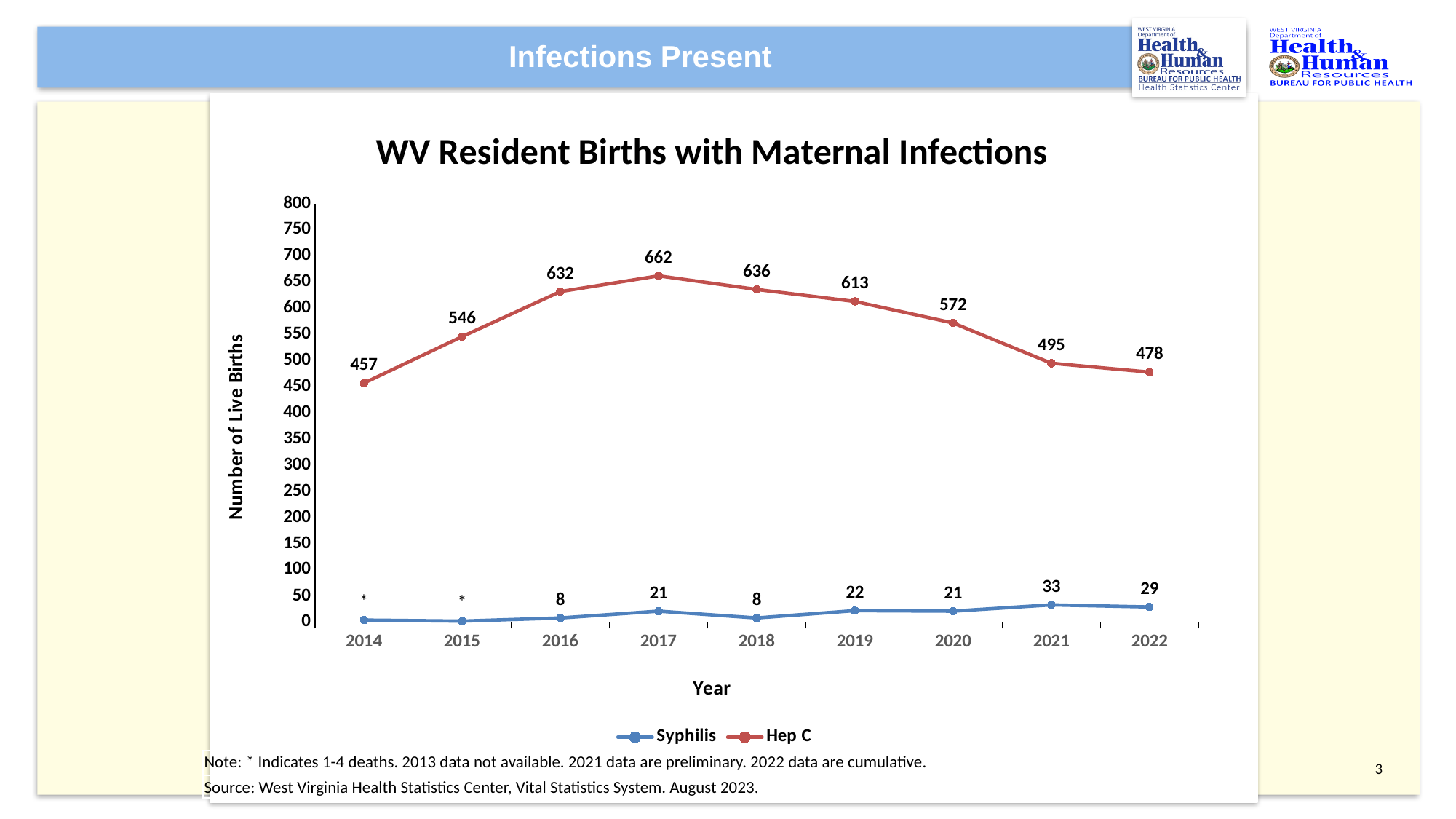
In which year is the Hep C series highest? 2017 What is the Syphilis value for 2021? 33 Is the Hep C value for 2020 greater or less than 550? greater Does the Hep C series rise or fall from 2017 to 2022? fall What is the Hep C value for 2017? 662 How many series does the legend list? 2 How many years are shown on the x axis? 9 In which year is the Hep C series lowest? 2014 What kind of chart is this? line chart What is the difference between the Hep C values for 2017 and 2022? 184 Which is larger, the Syphilis value for 2019 or for 2016? 2019 What is the Hep C value for 2014? 457